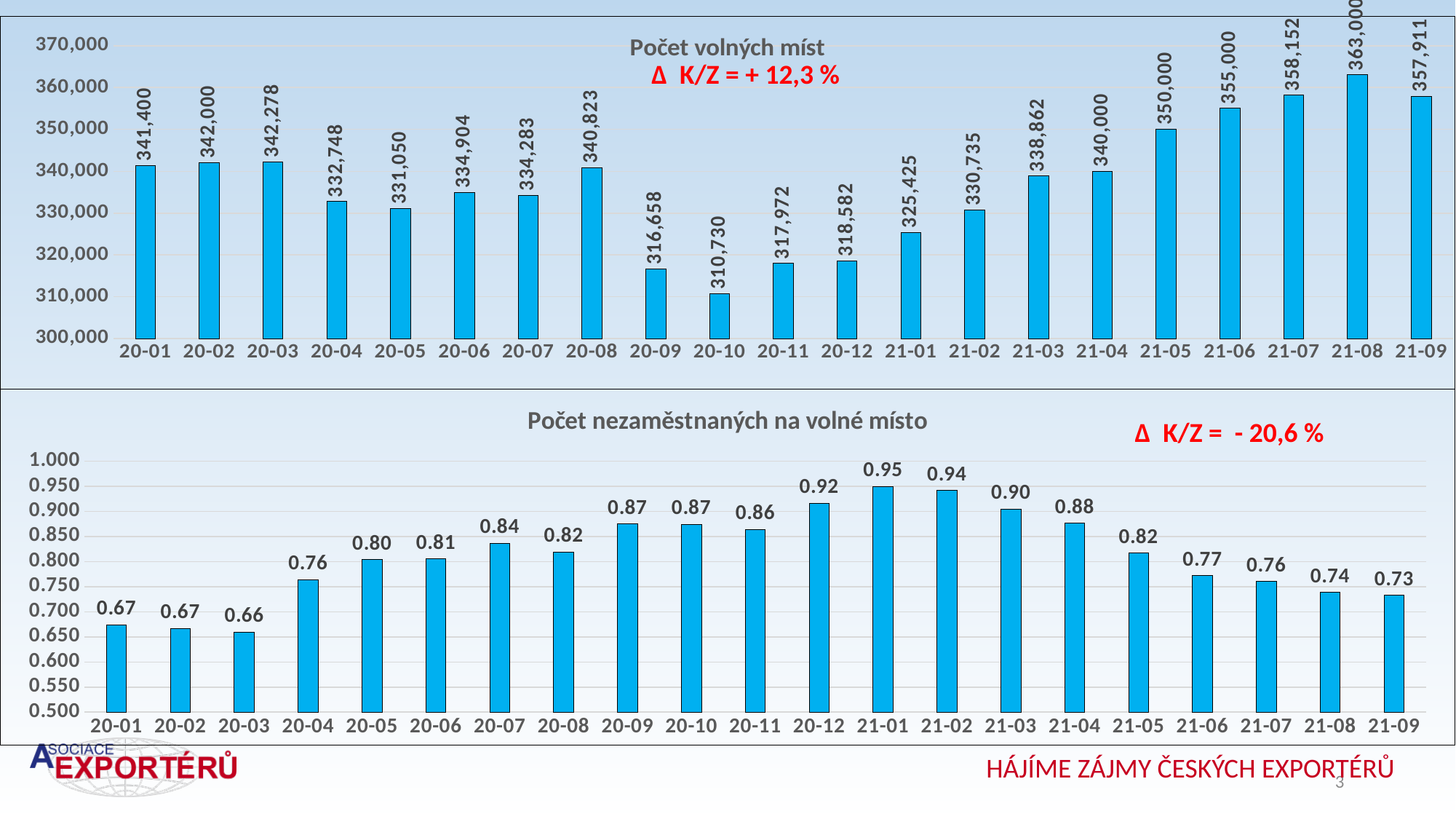
In the 'Počet volných míst' chart, what is the difference between the values for 21-09 and 20-09? 41,253 In the 'Počet nezaměstnaných na volné místo' chart, what is the value for 21-01? 0.95 In the 'Počet volných míst' chart, which month has the lowest value? 20-10 How many months are shown in the 'Počet volných míst' chart? 21 In the 'Počet nezaměstnaných na volné místo' chart, do the values rise or fall from 21-01 to 21-09? fall What percentage change is printed in red on the 'Počet volných míst' chart? + 12,3 % In the 'Počet volných míst' chart, which is larger, the value for 20-08 or the value for 21-02? 20-08 In the 'Počet nezaměstnaných na volné místo' chart, what is the difference between the values for 21-01 and 20-01? 0.28 In the 'Počet volných míst' chart, what is the value for 20-10? 310,730 What kind of chart is the 'Počet nezaměstnaných na volné místo' chart? bar chart In the 'Počet nezaměstnaných na volné místo' chart, which month has the lowest value? 20-03 In the 'Počet volných míst' chart, which month has the highest value? 21-08